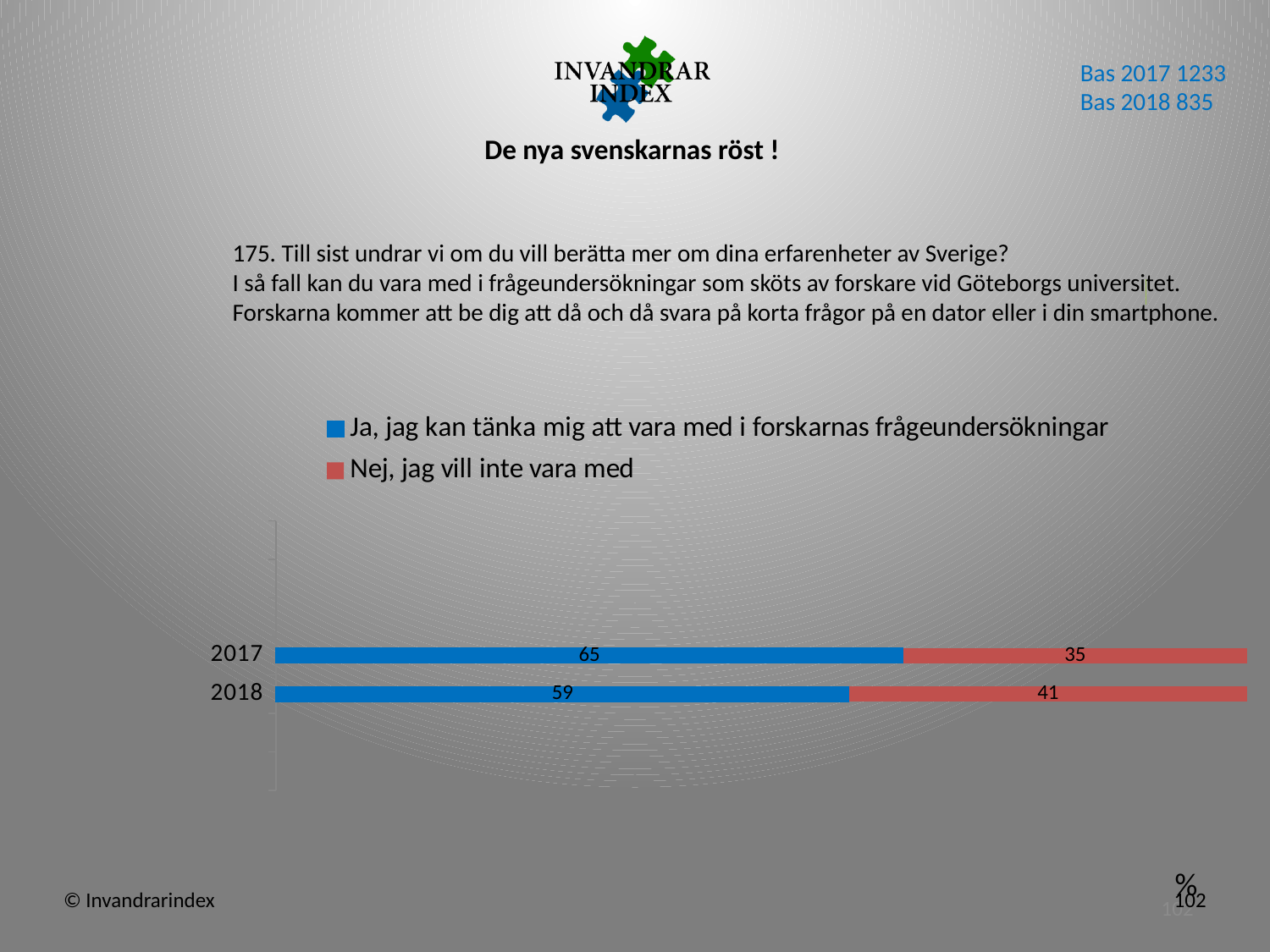
How many categories (years) are shown on the chart? 2 What is the value for "Nej, jag vill inte vara med" in 2018? 41 In which year is the value for "Nej, jag vill inte vara med" lowest? 2017 What is the difference between the "Ja" values for 2017 and 2018? 6 What is the total of the stacked bar for 2018? 100 In which year is the value for "Ja, jag kan tänka mig att vara med i forskarnas frågeundersökningar" highest? 2017 Which is larger in 2018: the "Ja" value or the "Nej" value? Ja, jag kan tänka mig att vara med i forskarnas frågeundersökningar What is the value for "Nej, jag vill inte vara med" in 2017? 35 What is the value for "Ja, jag kan tänka mig att vara med i forskarnas frågeundersökningar" in 2017? 65 What kind of chart is shown on the slide? Stacked bar chart How many series does the legend list? 2 What is the value for "Ja, jag kan tänka mig att vara med i forskarnas frågeundersökningar" in 2018? 59